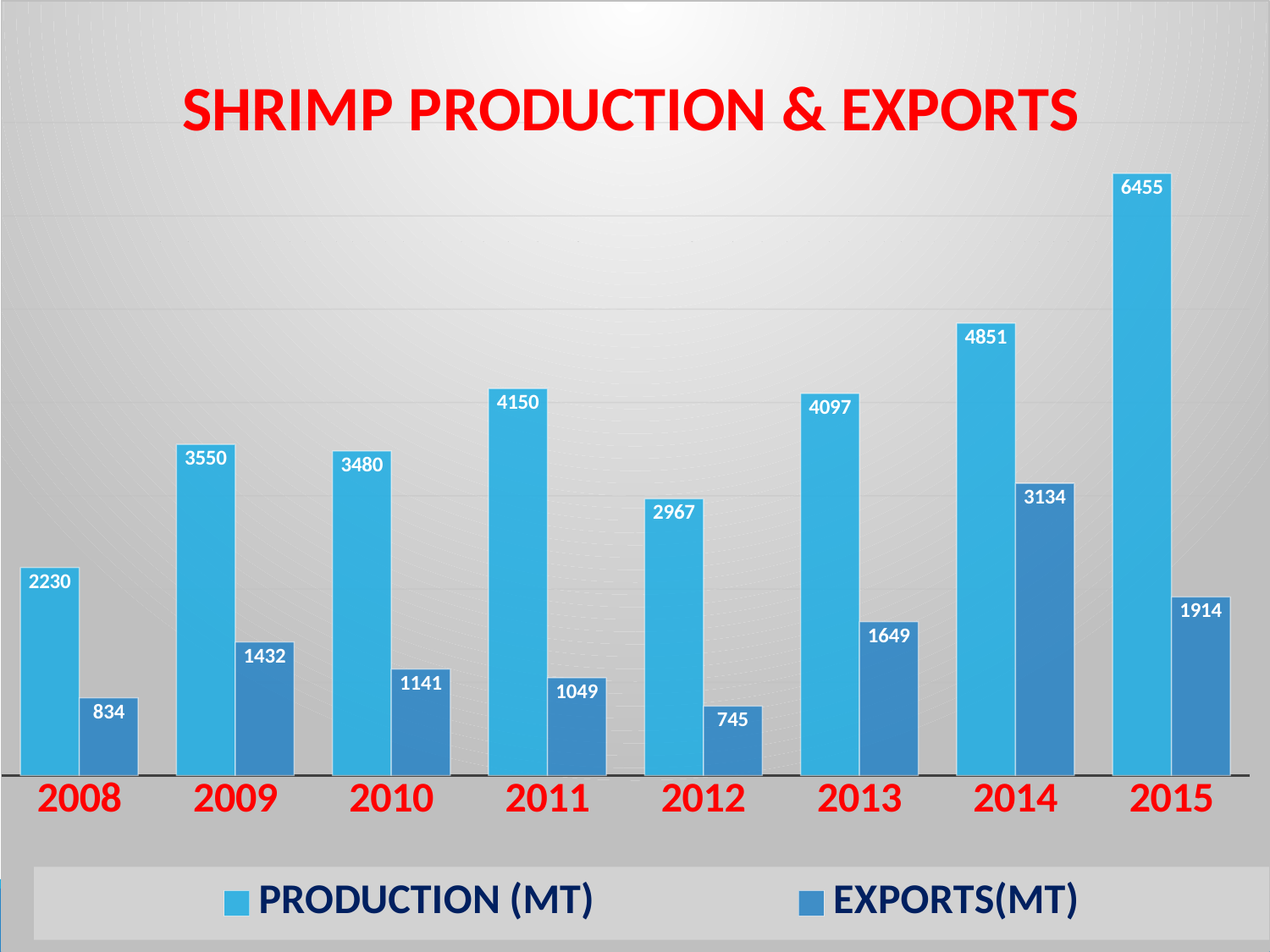
Did shrimp production rise or fall from 2014 to 2015? Rise What was the shrimp production (MT) in 2011? 4150 What was the shrimp production (MT) in 2008? 2230 What kind of chart is shown on the slide? Bar chart How many series does the legend list? 2 What was the value of shrimp exports (MT) in 2014? 3134 What is the difference between production and exports in 2015? 4541 How many years are shown on the x axis? 8 Which year had the lowest shrimp exports? 2012 Which year had the highest shrimp production? 2015 Which year had higher exports, 2013 or 2015? 2015 What is the title of the chart? SHRIMP PRODUCTION & EXPORTS